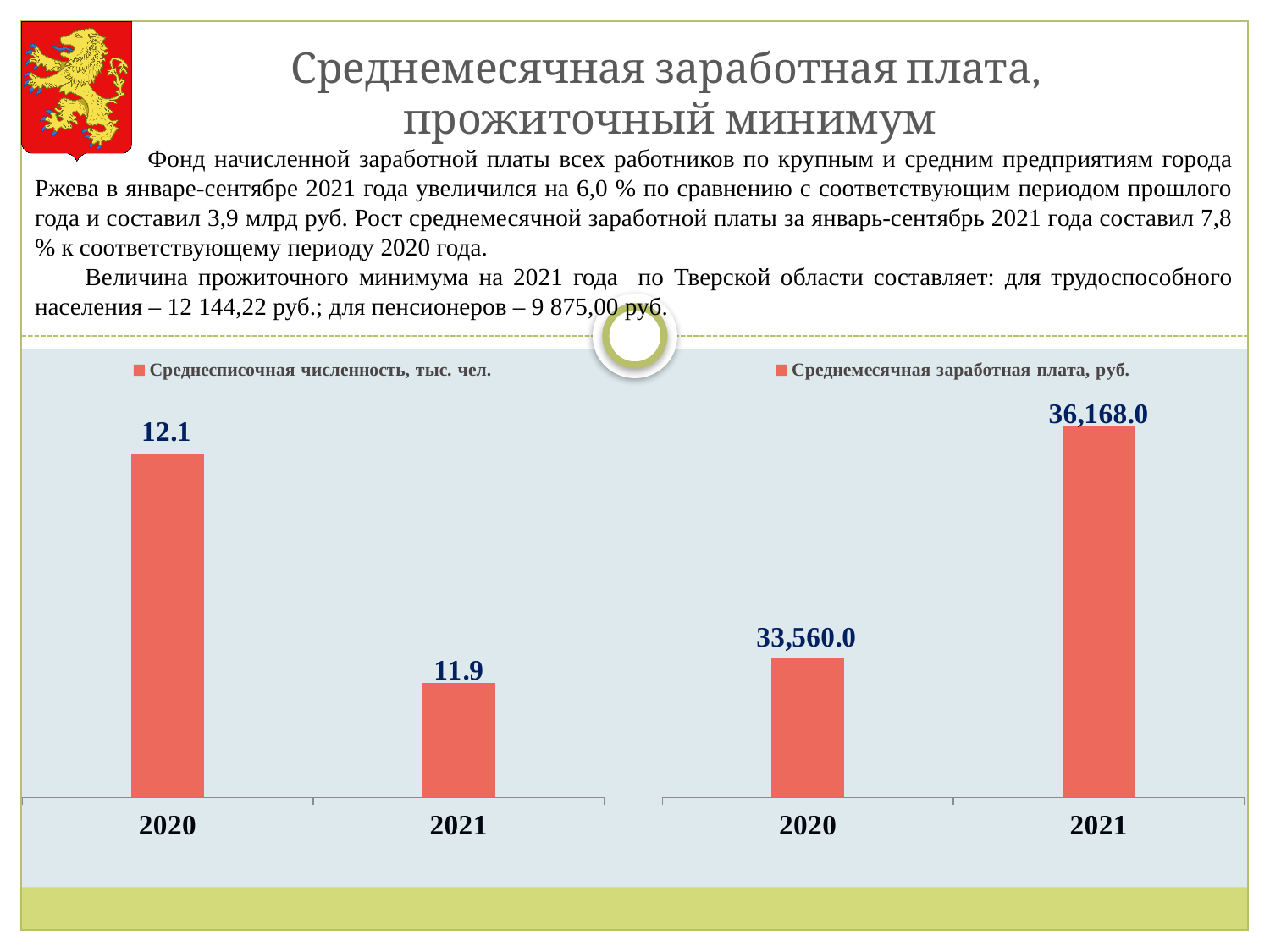
In the left chart (Среднесписочная численность, тыс. чел.), what is the difference between the 2020 and 2021 values? 0.2 In the right chart (Среднемесячная заработная плата, руб.), which year has the lower value? 2020 In the left chart (Среднесписочная численность, тыс. чел.), which year has the higher value? 2020 In the left chart (Среднесписочная численность, тыс. чел.), what is the value for 2021? 11.9 In the right chart (Среднемесячная заработная плата, руб.), by how much did the value increase from 2020 to 2021? 2,608.0 In the right chart (Среднемесячная заработная плата, руб.), what is the value for 2021? 36,168.0 In the right chart (Среднемесячная заработная плата, руб.), what is the value for 2020? 33,560.0 In the right chart (Среднемесячная заработная плата, руб.), is the value for 2021 larger or smaller than the value for 2020? larger In the left chart (Среднесписочная численность, тыс. чел.), do the values rise or fall from 2020 to 2021? fall In the left chart (Среднесписочная численность, тыс. чел.), what is the value for 2020? 12.1 What type of chart is the left chart (Среднесписочная численность, тыс. чел.)? bar chart How many bars are shown in the right chart (Среднемесячная заработная плата, руб.)? 2